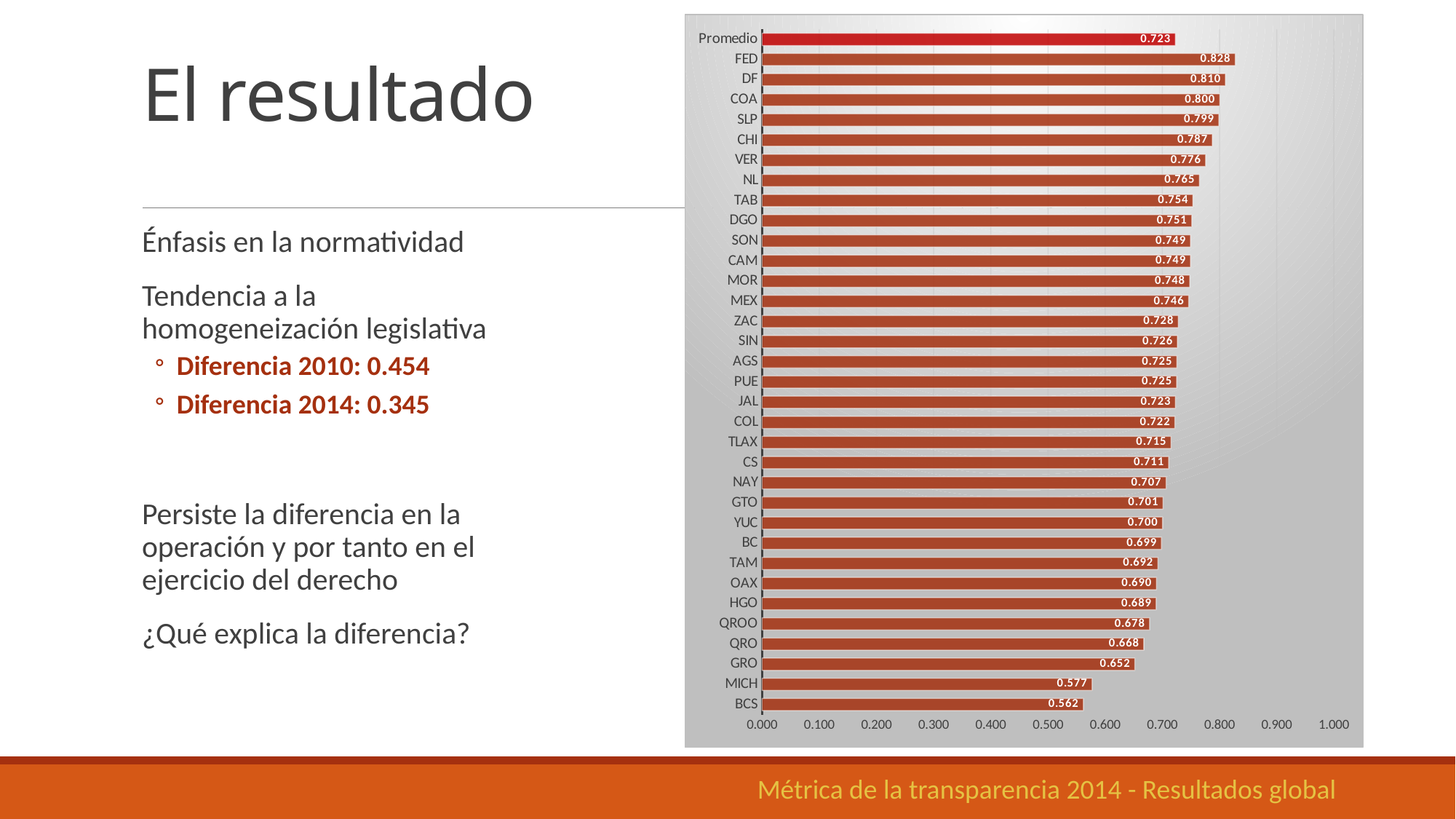
How many bars are plotted in the chart? 34 Which has a larger value, COA or GRO? COA Which bar is shown in a different colour (bright red) from the others? Promedio Which category has the lowest value? BCS What is the value for Promedio? 0.723 What is the value for FED? 0.828 Which category has the highest value? FED What is the difference between the values for DF and MICH? 0.233 What is the value for ZAC? 0.728 What kind of chart is shown on the slide? Bar chart What is the value for BCS? 0.562 What is the difference between the values for FED and BCS? 0.266